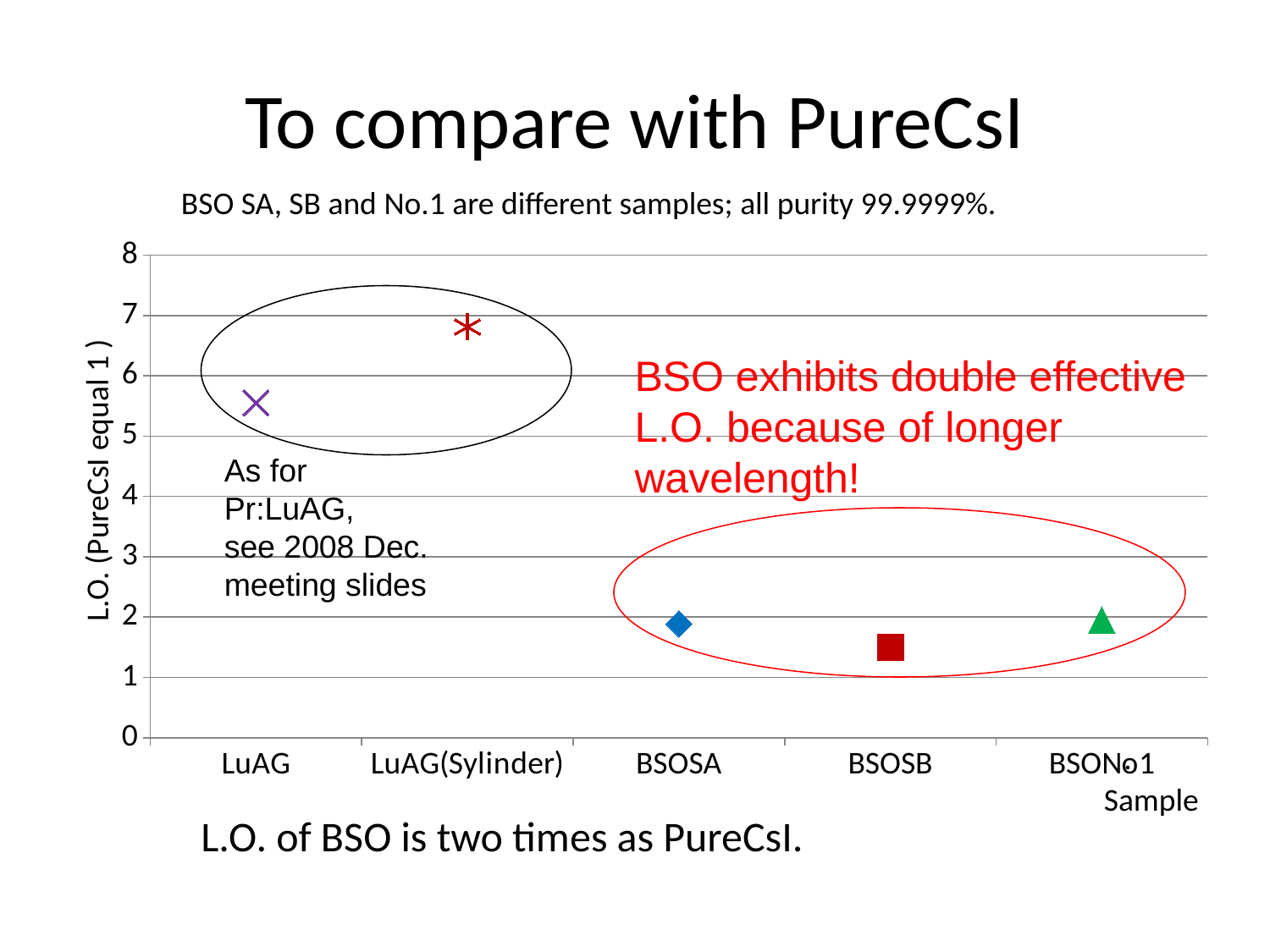
Which sample has the highest L.O. value? LuAG(Sylinder) What is the title of the y axis? L.O. (PureCsI equal 1 ) Which sample has the lowest L.O. value? BSOSB Is the value for LuAG greater or less than 5? greater Which has the larger L.O. value, LuAG or LuAG(Sylinder)? LuAG(Sylinder) How many samples are plotted along the x axis? 5 Is the value for LuAG(Sylinder) greater or less than 7? less What kind of chart is shown on the slide? scatter chart Is the value for BSOSB greater or less than 2? less What is the title of the x axis? Sample Which has the larger L.O. value, LuAG or BSOSA? LuAG